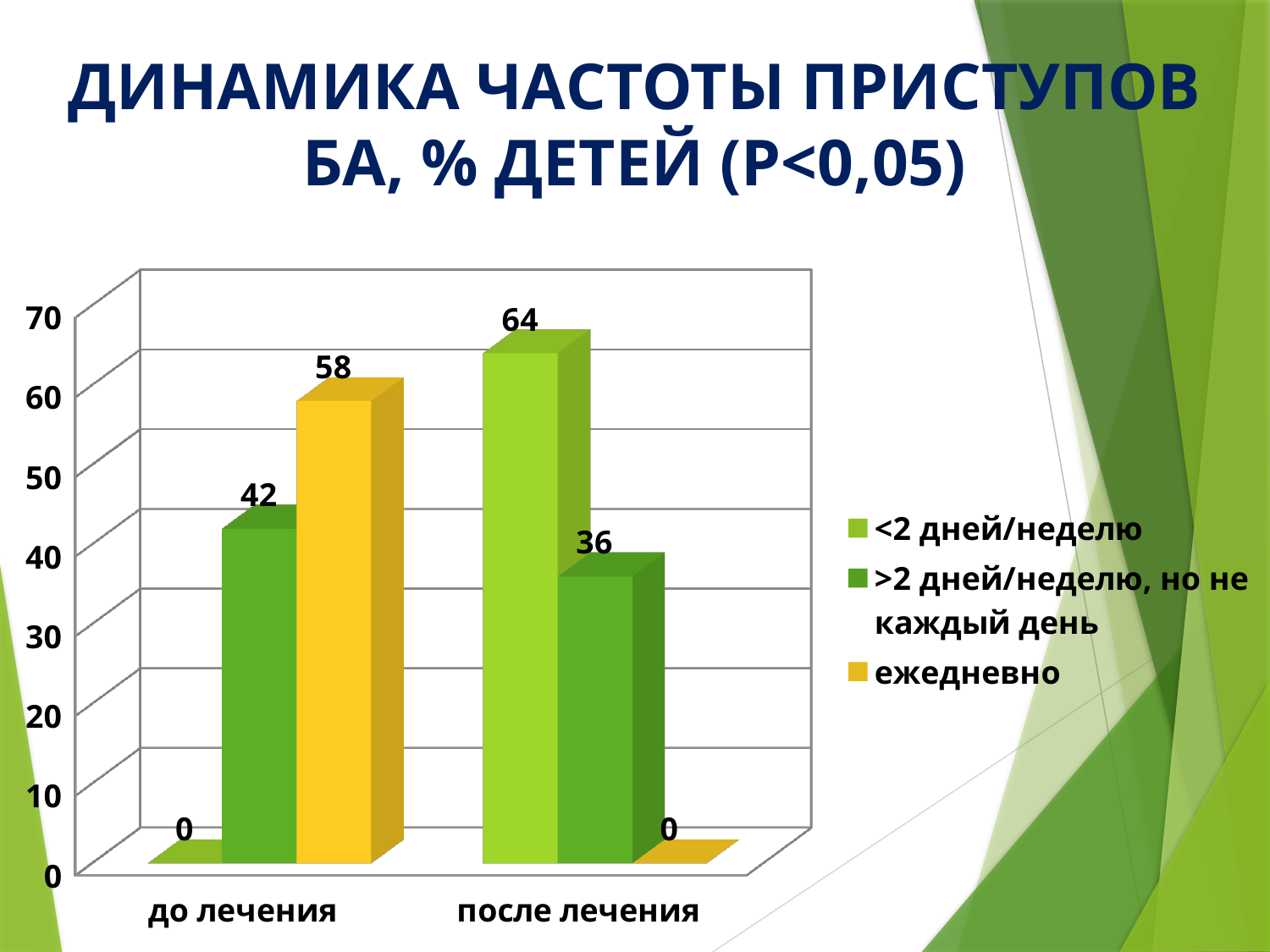
How many categories are shown on the x axis? 2 Which is larger: the '>2 дней/неделю, но не каждый день' value in 'до лечения' or in 'после лечения'? до лечения What is the value for 'ежедневно' in the 'после лечения' category? 0 Which series has the highest value in the 'после лечения' category? <2 дней/неделю Which series has the highest value in the 'до лечения' category? ежедневно What kind of chart is shown on the slide? Bar chart What is the value for '>2 дней/неделю, но не каждый день' in the 'до лечения' category? 42 What is the value for 'ежедневно' in the 'до лечения' category? 58 What is the value for '<2 дней/неделю' in the 'после лечения' category? 64 What is the difference between the 'ежедневно' value before treatment (до лечения) and the '>2 дней/неделю, но не каждый день' value before treatment? 16 What is the value for '<2 дней/неделю' in the 'до лечения' category? 0 How many series does the legend list? 3